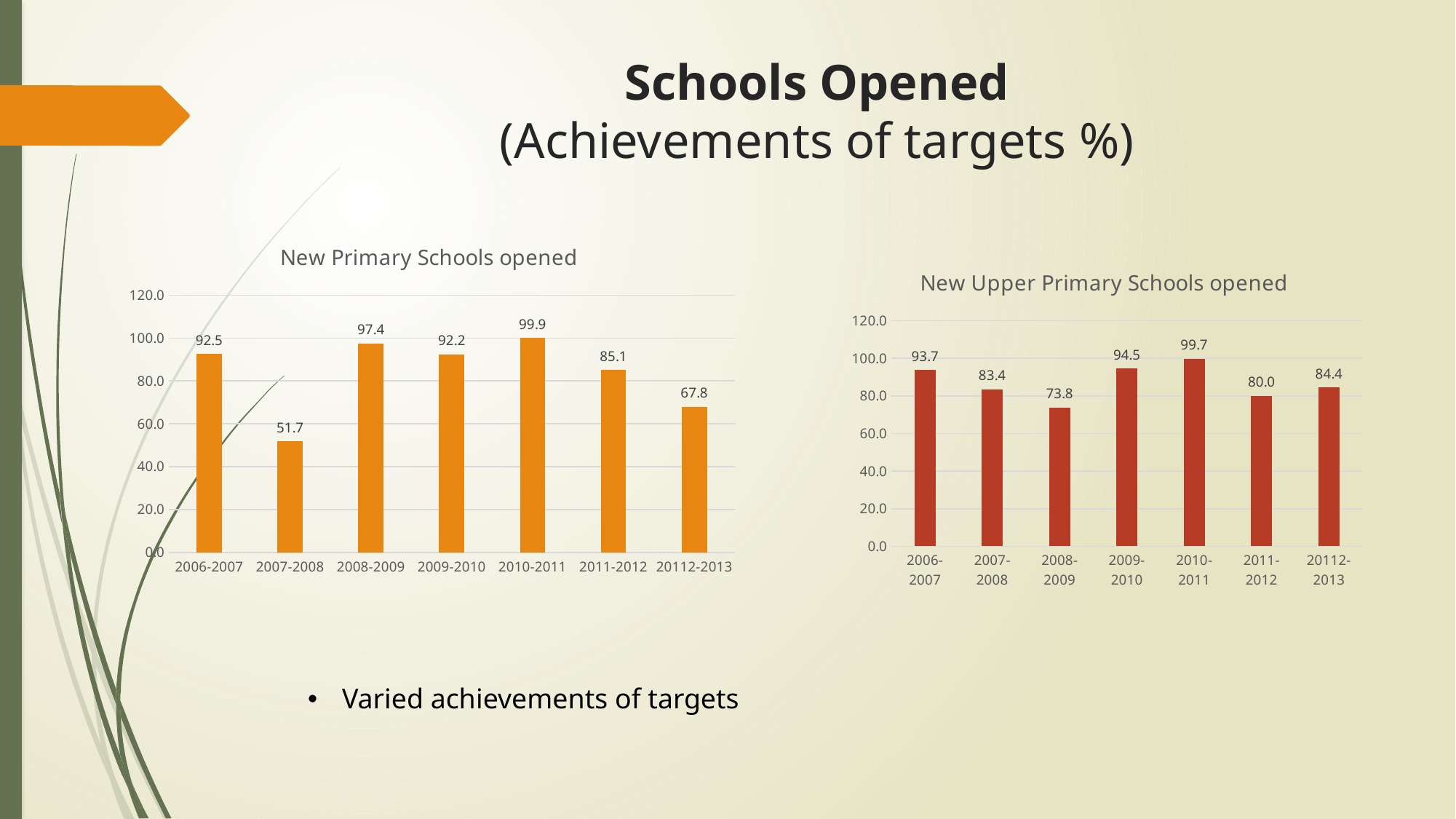
In the 'New Upper Primary Schools opened' chart, do the values rise or fall from 2007-2008 to 2008-2009? Fall What colour are the bars in the 'New Primary Schools opened' chart? Orange In the 'New Primary Schools opened' chart, what is the value for 2007-2008? 51.7 In the 'New Upper Primary Schools opened' chart, what is the difference between the values for 2010-2011 and 2011-2012? 19.7 What kind of chart is the 'New Upper Primary Schools opened' chart? Bar chart In the 'New Primary Schools opened' chart, which year has the highest value? 2010-2011 In the 'New Upper Primary Schools opened' chart, which year has the lowest value? 2008-2009 In the 'New Upper Primary Schools opened' chart, what is the value for 2008-2009? 73.8 How many bars are shown in the 'New Primary Schools opened' chart? 7 In the 'New Primary Schools opened' chart, which is larger: the value for 2011-2012 or the value for 20112-2013? 2011-2012 In the 'New Upper Primary Schools opened' chart, is the value for 2009-2010 greater or less than 80.0? greater In the 'New Primary Schools opened' chart, what is the difference between the values for 2010-2011 and 2007-2008? 48.2